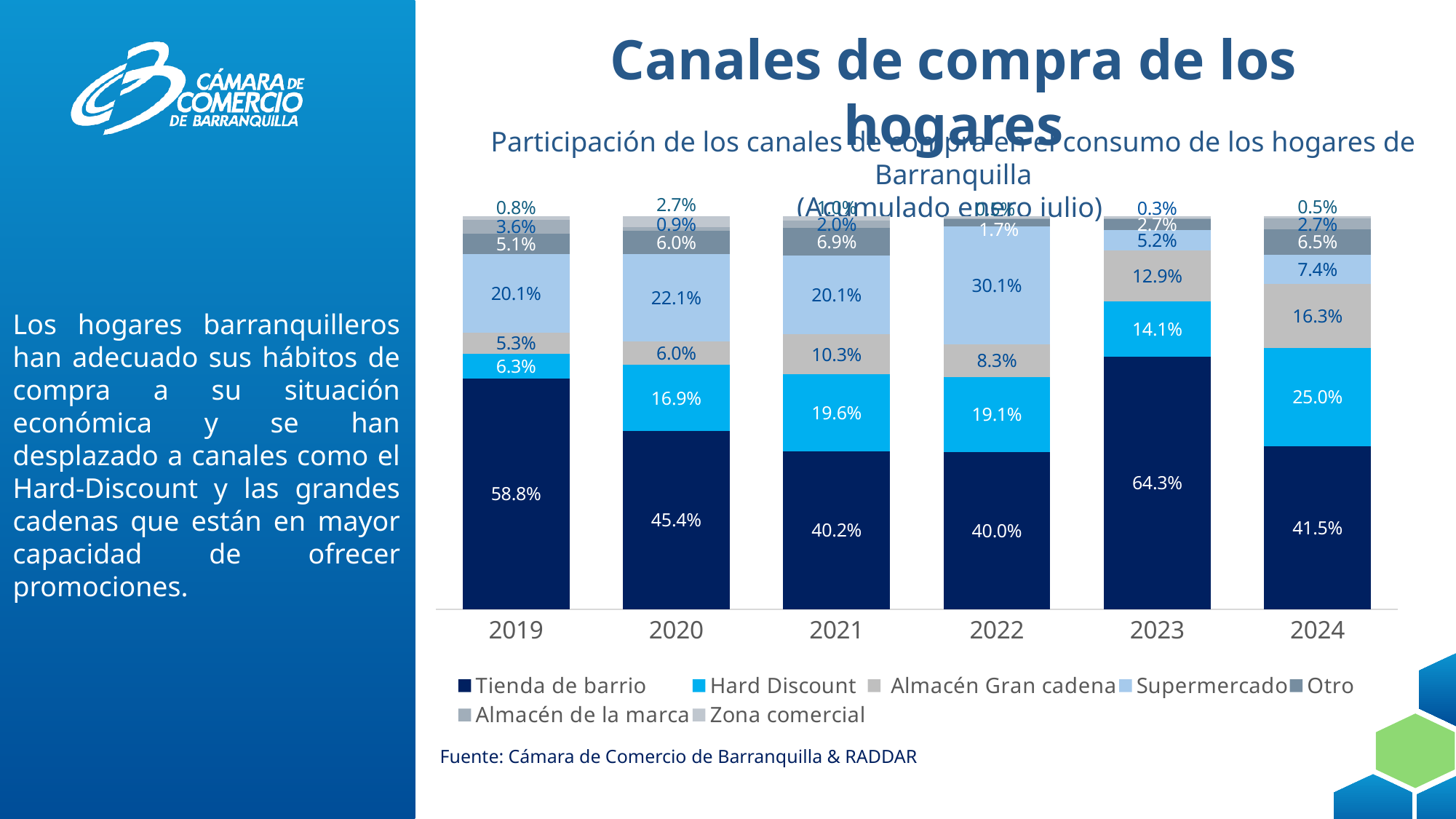
Which is larger, the Almacén Gran cadena share in 2023 or in 2024? 2024 What is the value for Tienda de barrio in 2019? 58.8% Does the Hard Discount share rise or fall from 2019 to 2021? Rise What is the value for Almacén Gran cadena in 2021? 10.3% How many years are shown on the x axis? 6 What is the difference between the Hard Discount share in 2024 and in 2019? 18.7 percentage points What is the value for Supermercado in 2022? 30.1% In which year is the Hard Discount share lowest? 2019 What is the value for Hard Discount in 2024? 25.0% How many series does the legend list? 7 What kind of chart is shown? Stacked bar chart In which year is the Tienda de barrio share highest? 2023